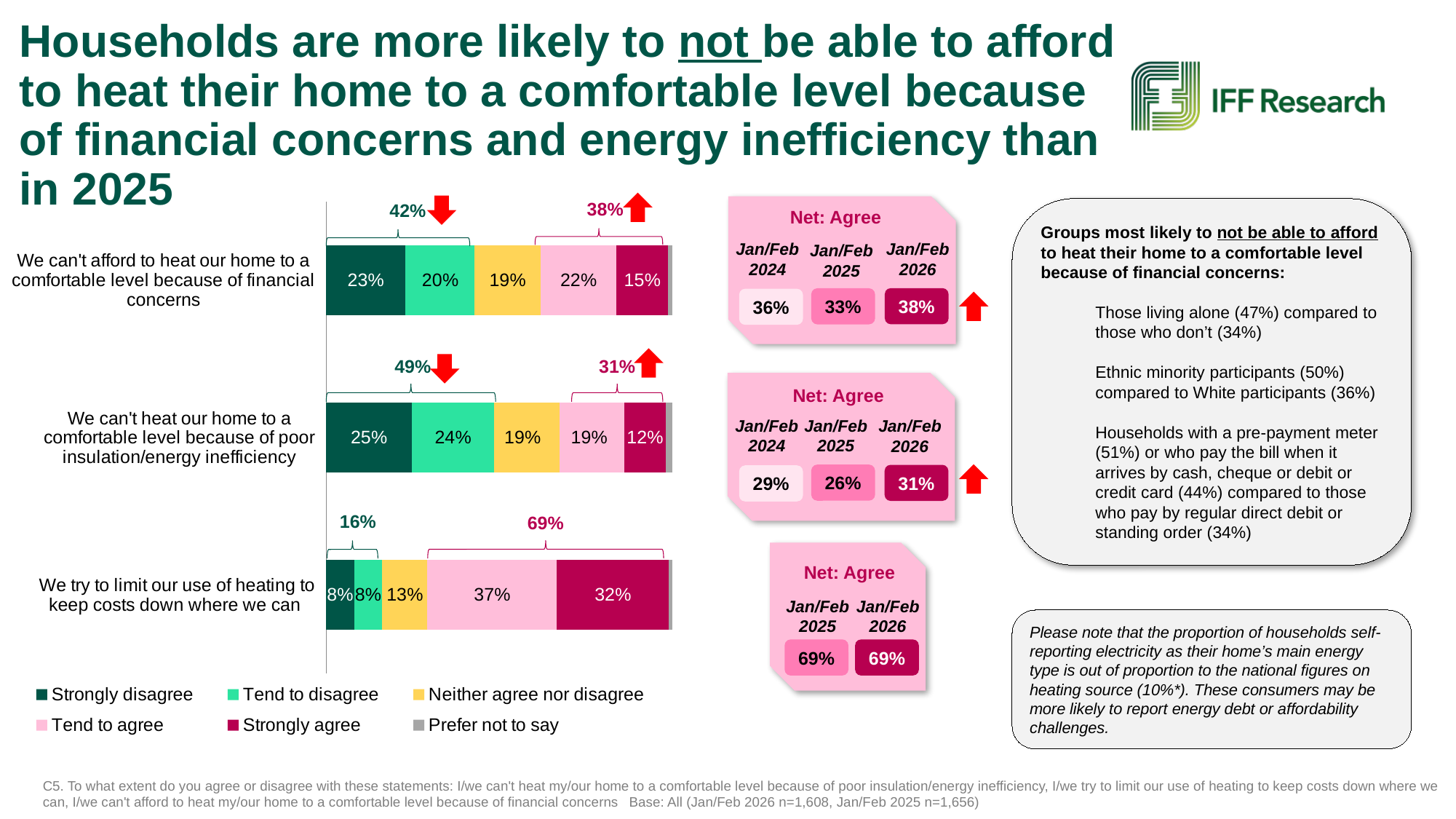
How many statements are shown in the stacked bar chart? 3 In the stacked bar chart, what percentage strongly agree with "We can't afford to heat our home to a comfortable level because of financial concerns"? 15% How many series does the legend of the stacked bar chart list? 6 In the stacked bar chart, what is the difference between the "Tend to agree" and "Strongly agree" percentages for "We try to limit our use of heating to keep costs down where we can"? 5 percentage points What kind of chart is used to show the agreement levels for the three statements? Stacked bar chart In the stacked bar chart, what percentage neither agree nor disagree with "We can't heat our home to a comfortable level because of poor insulation/energy inefficiency"? 19% In the stacked bar chart's legend, which response option is shown in grey? Prefer not to say In the stacked bar chart, which statement has the highest "Strongly agree" percentage? We try to limit our use of heating to keep costs down where we can In the stacked bar chart, what is the combined percentage of "Strongly disagree" and "Tend to disagree" for "We can't heat our home to a comfortable level because of poor insulation/energy inefficiency"? 49% In the stacked bar chart, which statement has the lowest "Strongly disagree" percentage? We try to limit our use of heating to keep costs down where we can In the stacked bar chart, what percentage tend to agree with "We try to limit our use of heating to keep costs down where we can"? 37% In the stacked bar chart, which statement has the larger "Strongly disagree" percentage: the financial concerns statement or the poor insulation/energy inefficiency statement? The poor insulation/energy inefficiency statement